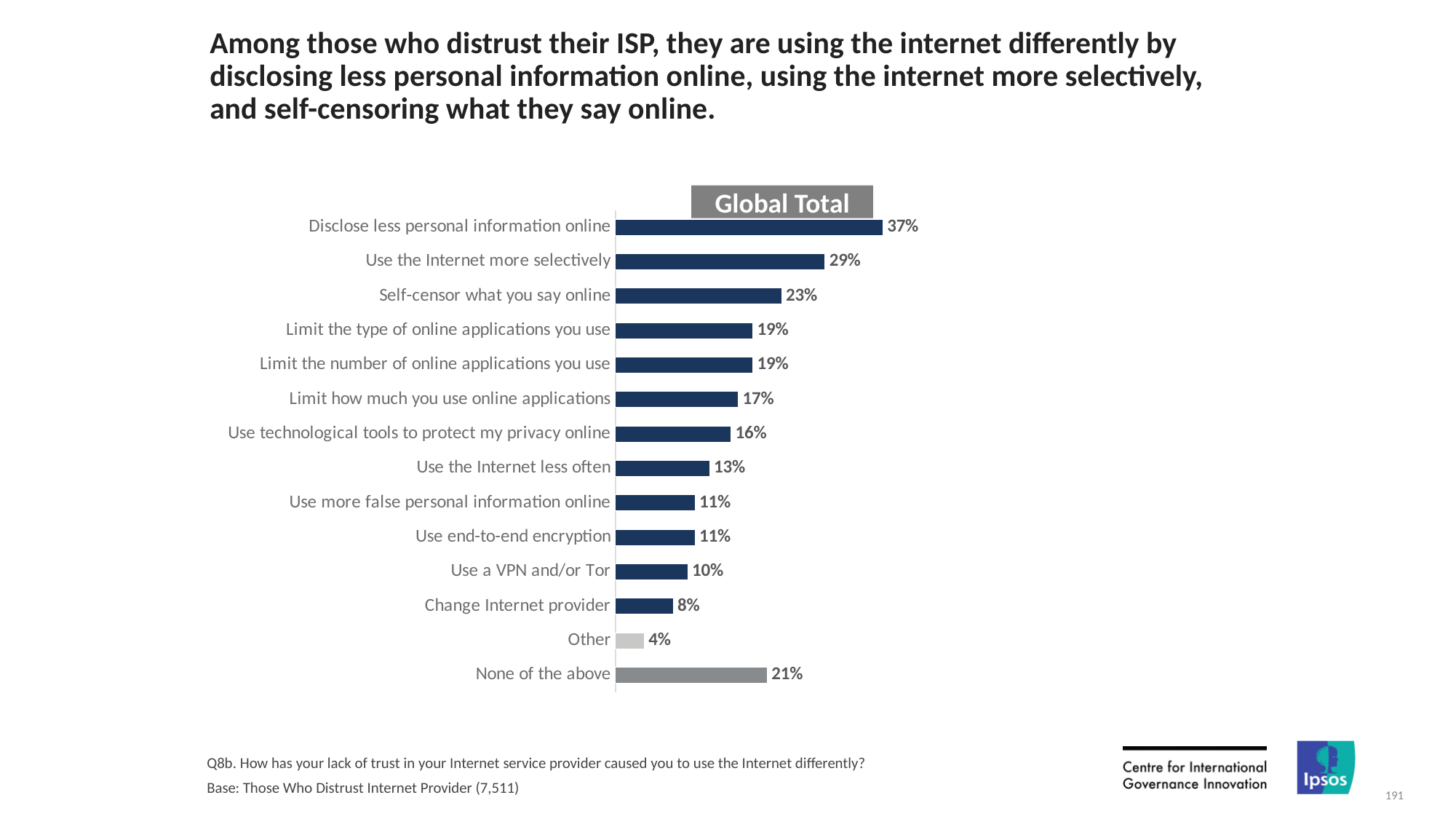
What is the difference between "Use the Internet more selectively" and "Self-censor what you say online"? 6% What is the value for "None of the above"? 21% What is the value for "Use technological tools to protect my privacy online"? 16% What percentage of respondents say they disclose less personal information online? 37% What is the value for "Use a VPN and/or Tor"? 10% What is the label shown in the grey box above the chart? Global Total Which is larger: "Use the Internet less often" or "Limit how much you use online applications"? Limit how much you use online applications How many categories are shown in the chart? 14 What type of chart is shown on the slide? Bar chart Which category has the lowest value? Other What is the difference between "Disclose less personal information online" and "Change Internet provider"? 29% Which category has the highest value? Disclose less personal information online